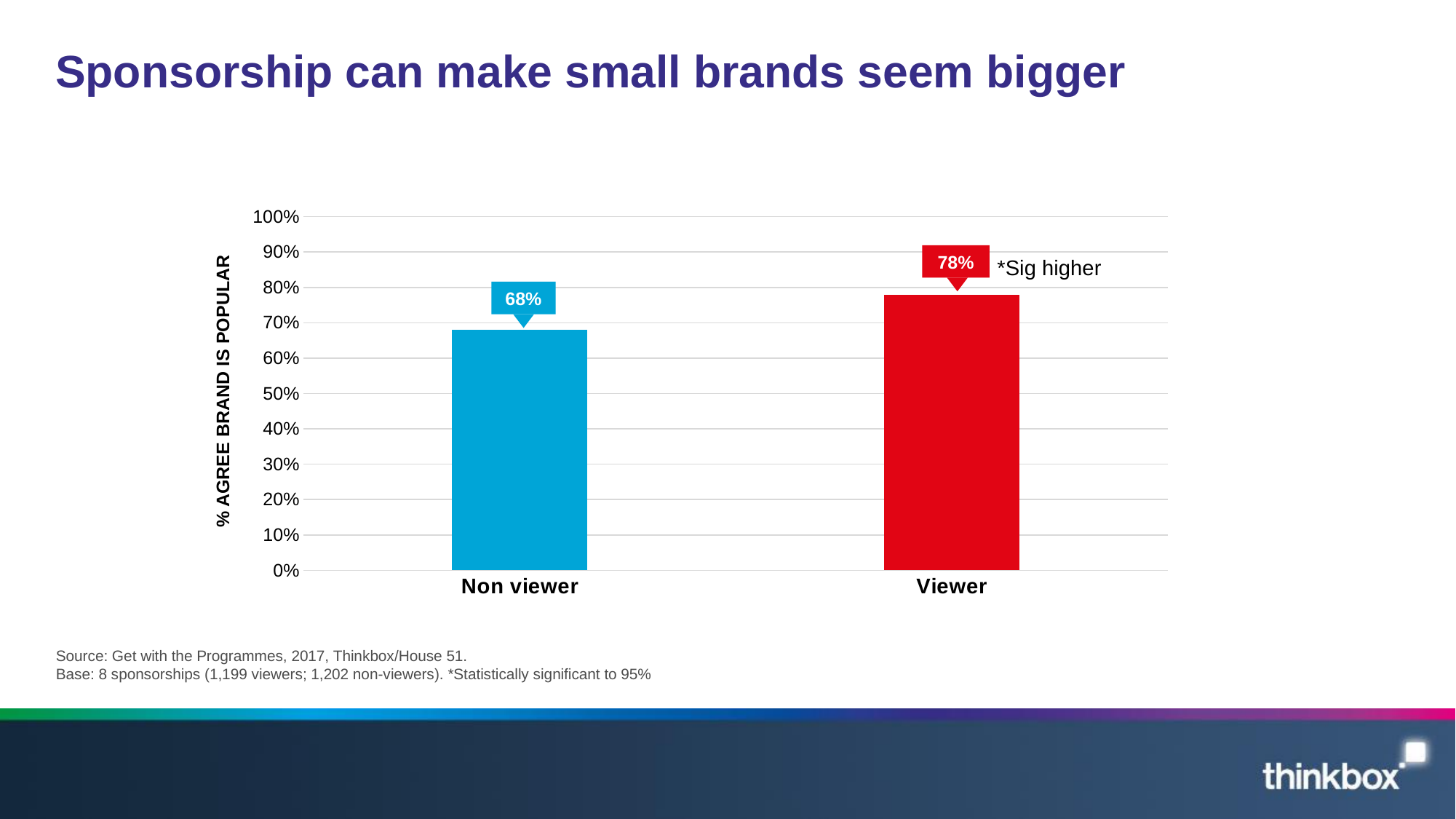
What colour is the Viewer bar? Red How many categories are shown on the x axis? 2 Which category has the lowest value? Non viewer What is the label of the vertical axis? % AGREE BRAND IS POPULAR What is the difference in percentage points between the Viewer and Non viewer values? 10 percentage points Which category has the higher value, Non viewer or Viewer? Viewer What percentage of viewers agree the brand is popular? 78% Is the value for Non viewer greater or less than 70%? less Is the value for Viewer greater or less than 70%? greater What is the maximum value shown on the vertical axis? 100% What percentage of non viewers agree the brand is popular? 68% What kind of chart is shown on the slide? Bar chart